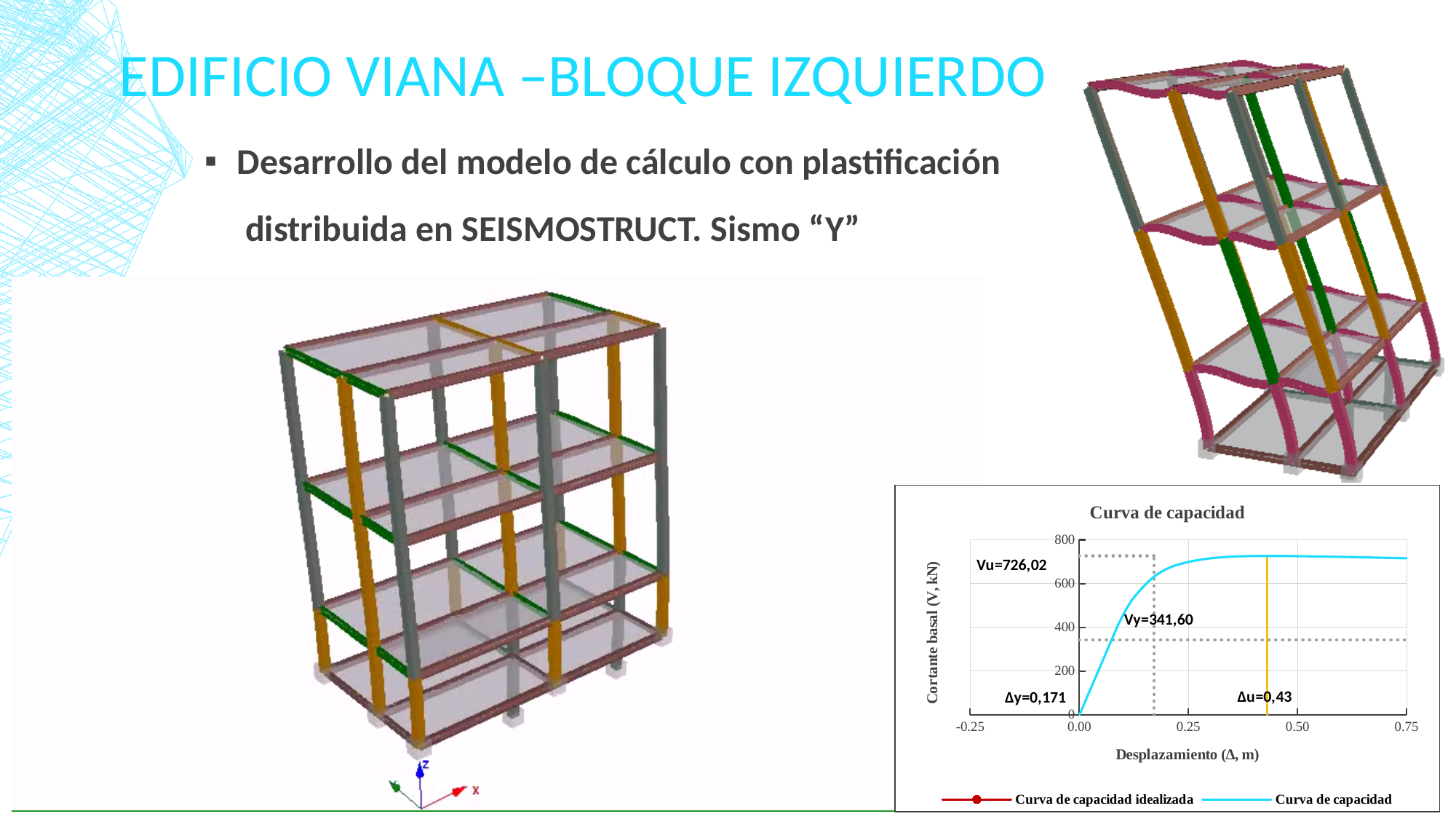
In the "Curva de capacidad" chart, what is the value of Δu? 0,43 In the "Curva de capacidad" chart, what is the value of Vu? 726,02 How many series does the legend of the "Curva de capacidad" chart list? 2 What kind of chart is the "Curva de capacidad" chart? line chart What is the title of the chart on the slide? Curva de capacidad In the "Curva de capacidad" chart, does the capacity curve rise or fall as displacement increases from 0.00 to 0.25 m? rise In the "Curva de capacidad" chart, which is larger, Vu or Vy? Vu In the "Curva de capacidad" chart, is the base shear of the capacity curve at a displacement of 0.50 m greater or less than 600? greater In the "Curva de capacidad" chart, what is the value of Δy? 0,171 In the "Curva de capacidad" chart, what is the difference between Δu and Δy? 0,259 In the "Curva de capacidad" chart, what is the difference between Vu and Vy? 384,42 In the "Curva de capacidad" chart, what is the value of Vy? 341,60